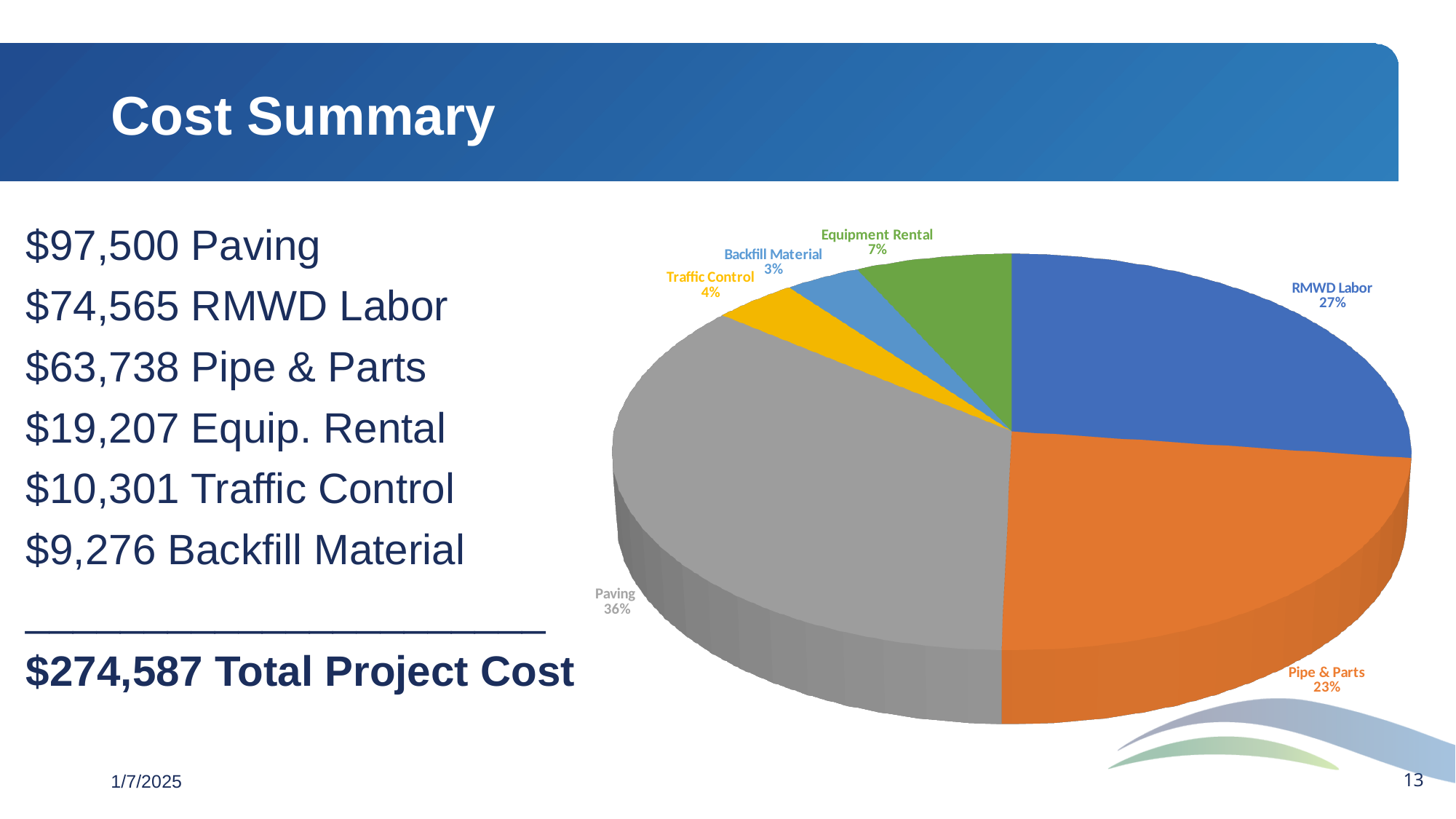
Which category has the smallest slice in the pie chart? Backfill Material What is the difference in percentage points between the Paving and RMWD Labor slices? 9 Which slice is larger, Traffic Control or Equipment Rental? Equipment Rental What percentage share does Backfill Material have in the pie chart? 3% What percentage share does RMWD Labor have in the pie chart? 27% Which category has the largest slice in the pie chart? Paving What percentage share does Equipment Rental have in the pie chart? 7% What colour is the Paving slice in the pie chart? gray What kind of chart is shown on the slide? pie chart How many slices does the pie chart have? 6